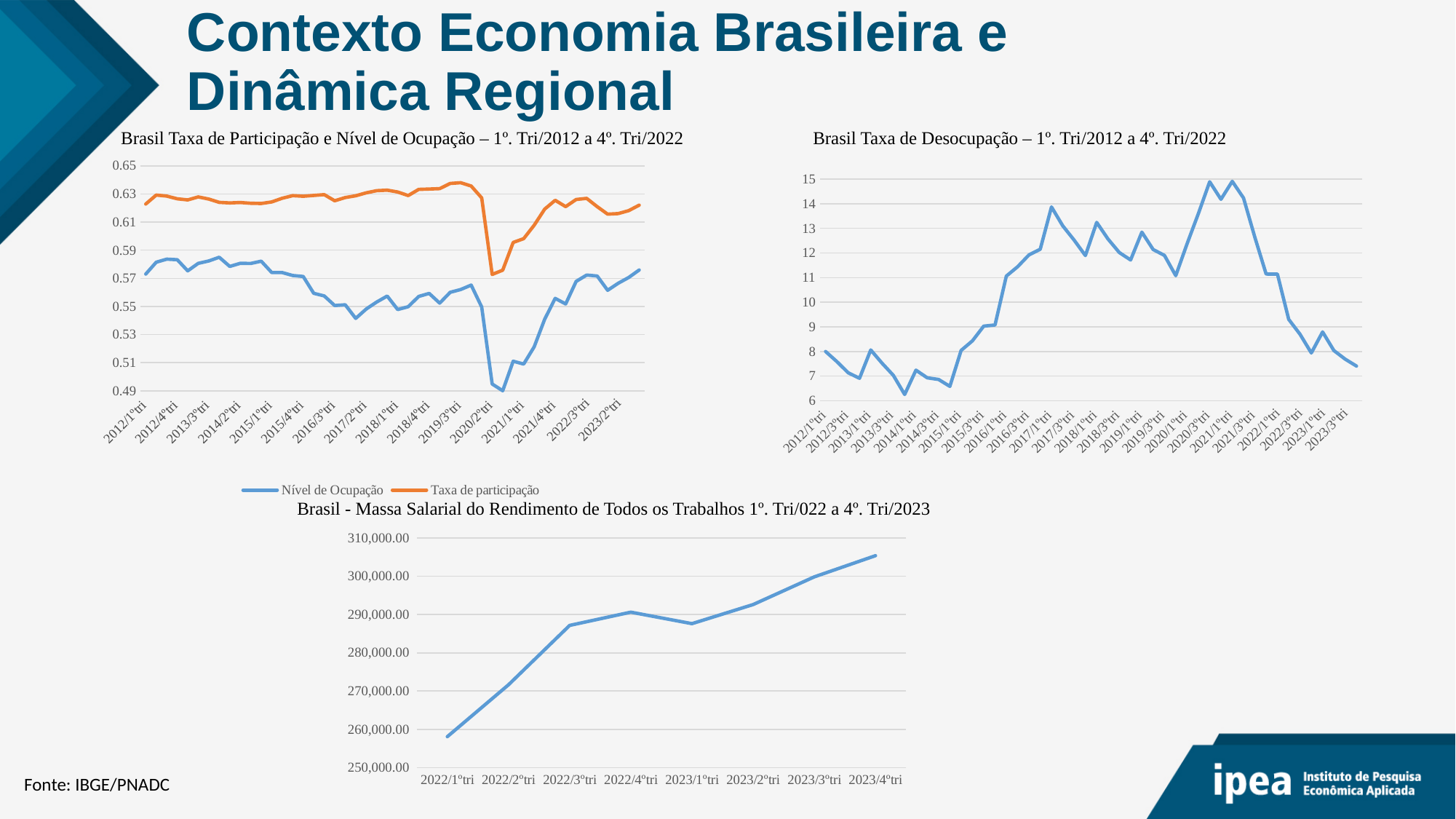
What type of chart is 'Brasil Taxa de Desocupação – 1º. Tri/2012 a 4º. Tri/2022'? Line chart In the chart 'Brasil Taxa de Participação e Nível de Ocupação', is the value of Nível de Ocupação at 2020/2ºtri greater or less than 0.51? less In the chart 'Brasil Taxa de Desocupação – 1º. Tri/2012 a 4º. Tri/2022', is the value at 2017/1ºtri greater or less than 13? greater In the chart 'Brasil Taxa de Desocupação – 1º. Tri/2012 a 4º. Tri/2022', which is larger, the value at 2016/3ºtri or the value at 2013/1ºtri? 2016/3ºtri In the chart 'Brasil - Massa Salarial do Rendimento de Todos os Trabalhos', which quarter has the lowest value? 2022/1ºtri In the chart 'Brasil - Massa Salarial do Rendimento de Todos os Trabalhos', is the value at 2023/4ºtri greater or less than 300,000.00? greater In the chart 'Brasil Taxa de Participação e Nível de Ocupação', which series is higher at 2012/1ºtri, Nível de Ocupação or Taxa de participação? Taxa de participação How many data points are plotted in the chart 'Brasil - Massa Salarial do Rendimento de Todos os Trabalhos 1º. Tri/022 a 4º. Tri/2023'? 8 How many series does the legend list in the chart 'Brasil Taxa de Participação e Nível de Ocupação – 1º. Tri/2012 a 4º. Tri/2022'? 2 In the chart 'Brasil Taxa de Participação e Nível de Ocupação', which series is plotted in orange? Taxa de participação In the chart 'Brasil - Massa Salarial do Rendimento de Todos os Trabalhos', which quarter has the highest value? 2023/4ºtri